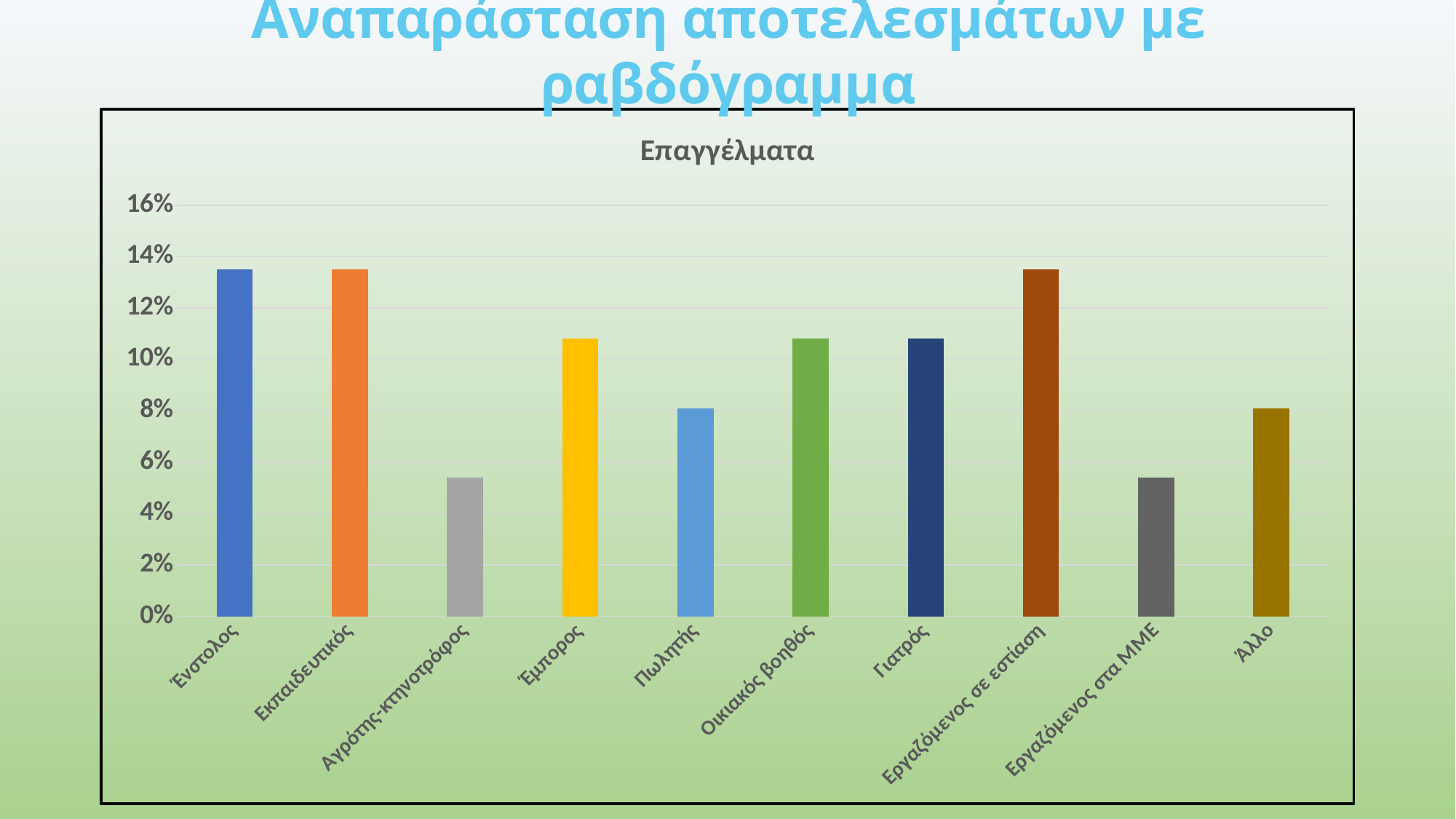
Is the value for Αγρότης-κτηνοτρόφος greater or less than 6%? less Is the value for Έμπορος greater or less than 10%? greater What kind of chart is shown on the slide? bar chart What is the title of the chart? Επαγγέλματα Which is larger, the value for Άλλο or the value for Γιατρός? Γιατρός Is the value for Εργαζόμενος στα ΜΜΕ greater or less than 8%? less Which is larger, the value for Εκπαιδευτικός or the value for Πωλητής? Εκπαιδευτικός Which is larger, the value for Αγρότης-κτηνοτρόφος or the value for Οικιακός βοηθός? Οικιακός βοηθός How many categories (professions) are plotted in the chart? 10